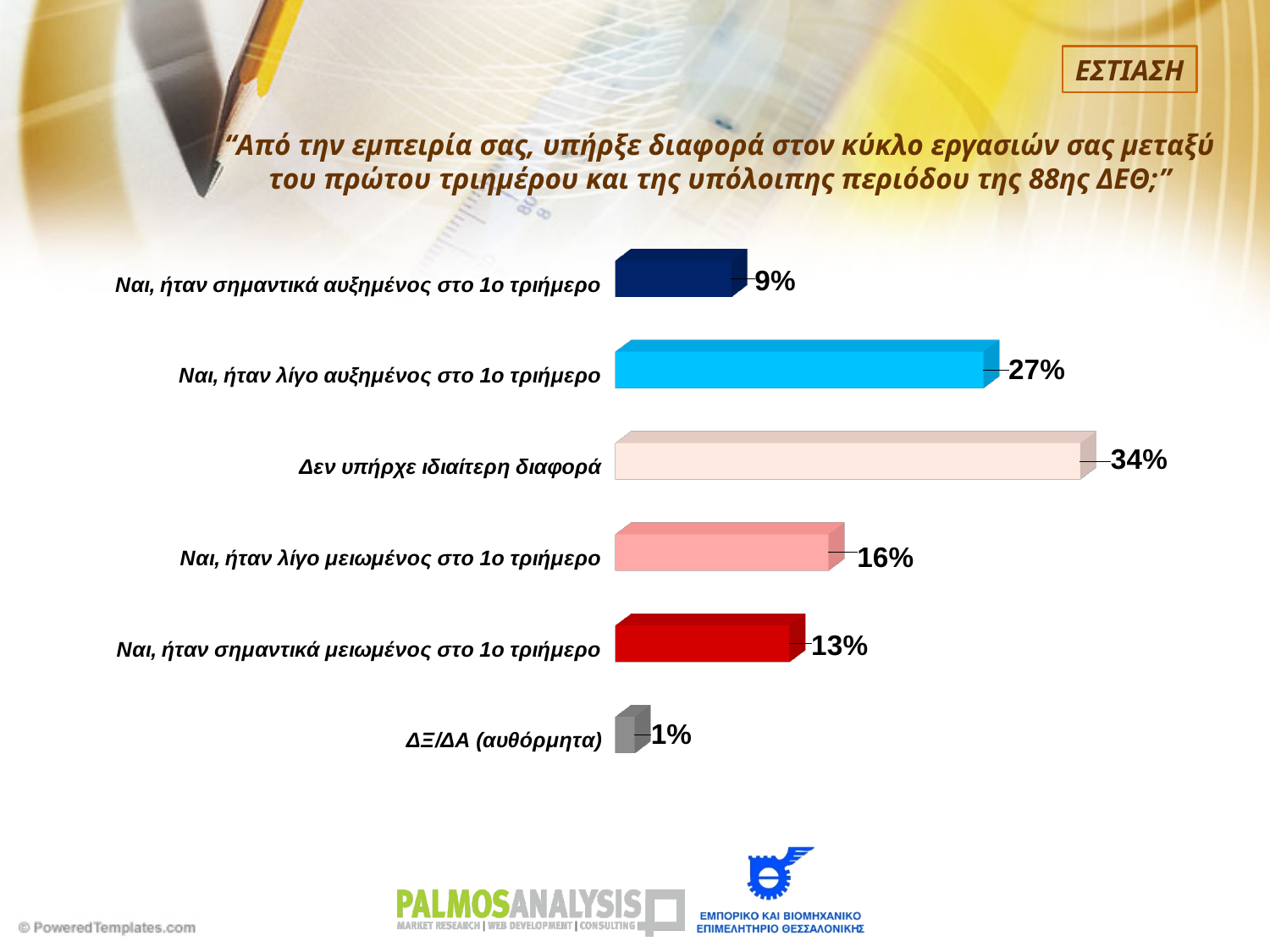
What percentage is shown for "Ναι, ήταν λίγο μειωμένος στο 1ο τριήμερο"? 16% What is the difference between "Ναι, ήταν λίγο αυξημένος στο 1ο τριήμερο" and "Ναι, ήταν σημαντικά αυξημένος στο 1ο τριήμερο"? 18% What is the difference between "Δεν υπήρχε ιδιαίτερη διαφορά" and "Ναι, ήταν σημαντικά μειωμένος στο 1ο τριήμερο"? 21% What is the value for "ΔΞ/ΔΑ (αυθόρμητα)"? 1% Which response category has the lowest percentage? ΔΞ/ΔΑ (αυθόρμητα) Which response category has the highest percentage? Δεν υπήρχε ιδιαίτερη διαφορά Which is larger: "Ναι, ήταν λίγο μειωμένος στο 1ο τριήμερο" or "Ναι, ήταν σημαντικά μειωμένος στο 1ο τριήμερο"? Ναι, ήταν λίγο μειωμένος στο 1ο τριήμερο What type of chart is shown on the slide? Bar chart What colour is the bar for "Ναι, ήταν σημαντικά μειωμένος στο 1ο τριήμερο"? Red What percentage of respondents answered "Ναι, ήταν σημαντικά αυξημένος στο 1ο τριήμερο"? 9% How many response categories are shown in the chart? 6 What is the value shown for "Δεν υπήρχε ιδιαίτερη διαφορά"? 34%